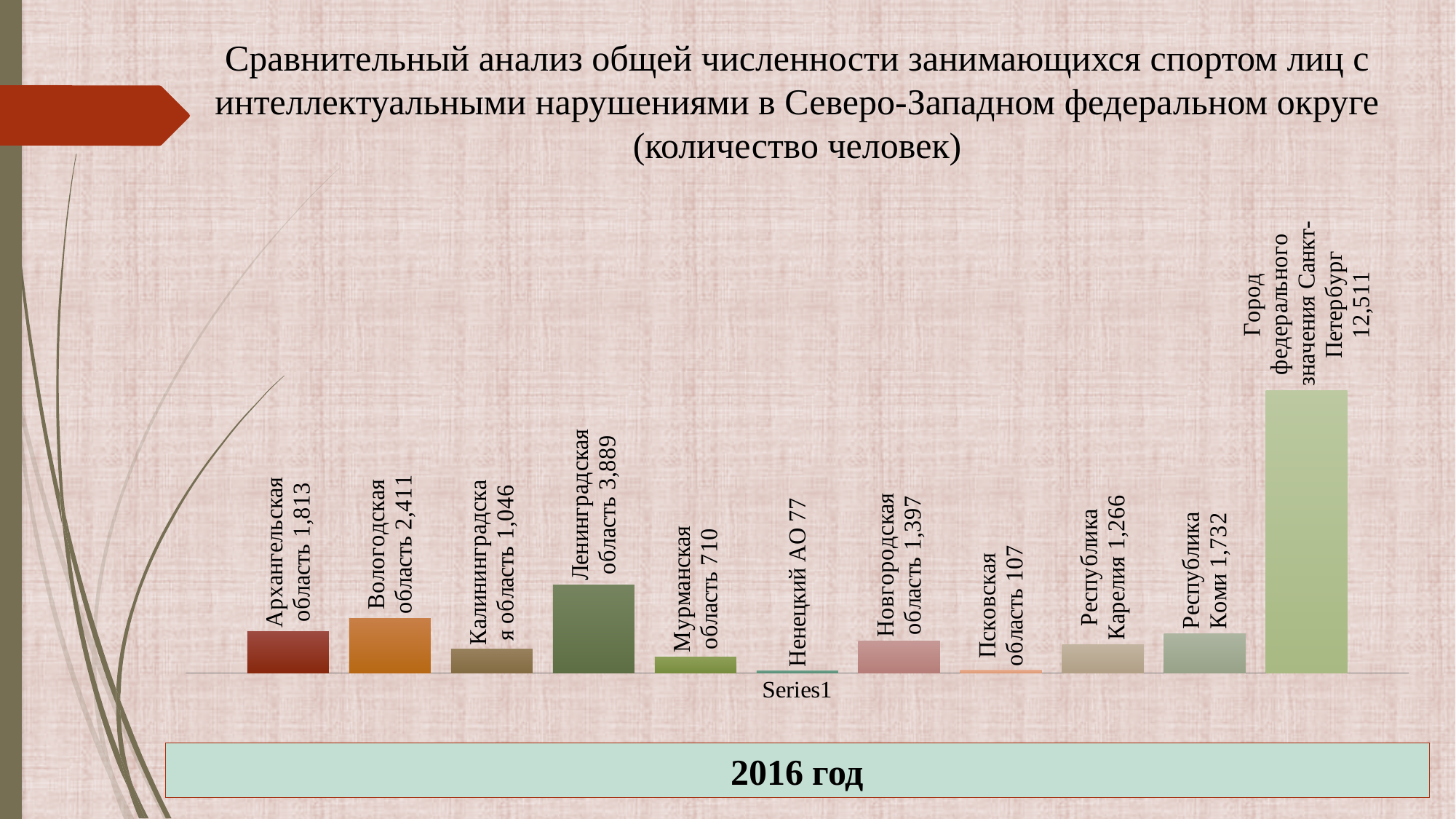
Which is larger, the value for Республика Карелия or the value for Новгородская область? Новгородская область What is the value for Ленинградская область? 3,889 Which region has the lowest value? Ненецкий АО What is the difference between the values for Псковская область and Ненецкий АО? 30 How many regions are shown in the chart? 11 What is the value for Ненецкий АО? 77 Which is larger, the value for Мурманская область or the value for Калининградская область? Калининградская область What is the value for Республика Коми? 1,732 What year is indicated in the box below the chart? 2016 год Which region has the highest value? Город федерального значения Санкт-Петербург What is the difference between the values for Вологодская область and Архангельская область? 598 What kind of chart is shown on the slide? Bar chart